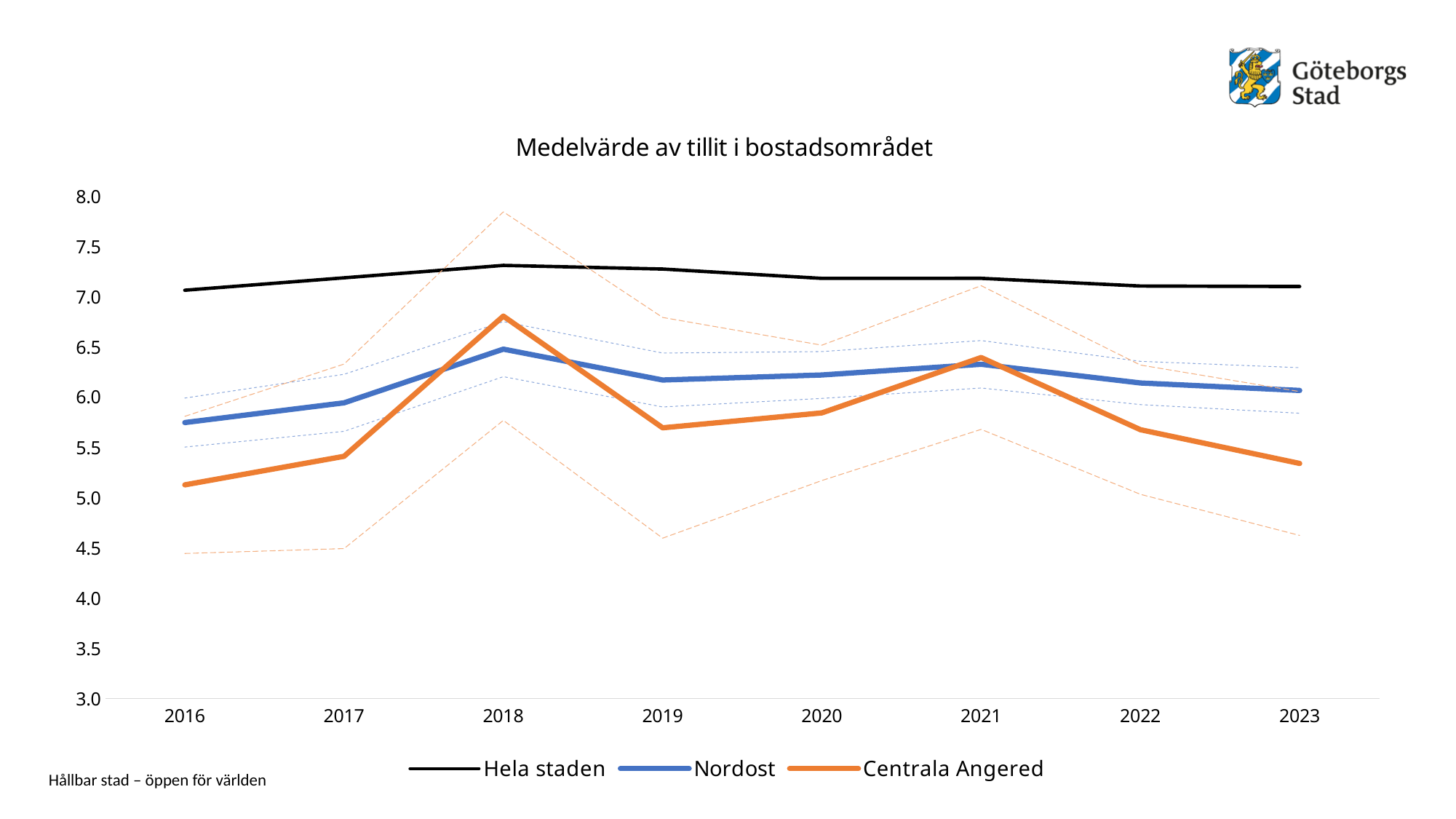
What is the title of the chart? Medelvärde av tillit i bostadsområdet Is the value for Nordost in 2016 greater or less than 6.0? less Is the value for Hela staden in 2018 greater or less than 7.0? greater In which year does Centrala Angered have its lowest value? 2016 In which year does Centrala Angered reach its highest value? 2018 How many years are shown on the x axis? 8 In which year does Nordost reach its highest value? 2018 What kind of chart is shown on the slide? line chart How many series does the legend list? 3 In 2023, which is higher: Nordost or Centrala Angered? Nordost Does the Centrala Angered line rise or fall from 2021 to 2023? fall Is the value for Centrala Angered in 2016 greater or less than 5.5? less